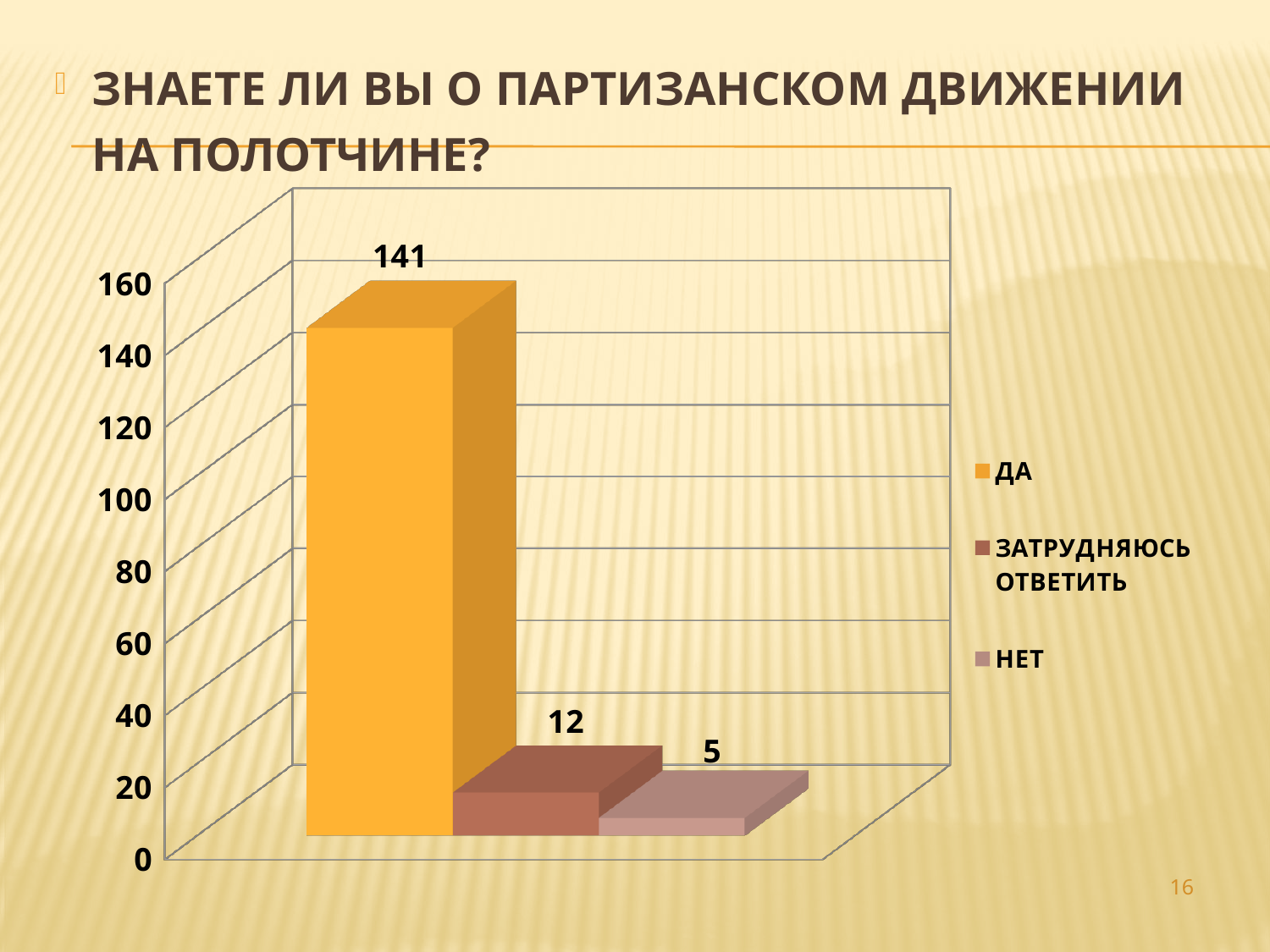
What is the value for НЕТ? 5 What is the value for ЗАТРУДНЯЮСЬ ОТВЕТИТЬ? 12 What kind of chart is shown on the slide? bar chart Is the value for ДА greater or less than 120? greater What is the difference between the values for ДА and ЗАТРУДНЯЮСЬ ОТВЕТИТЬ? 129 What is the value for ДА? 141 What colour is the bar for ДА? orange Which category has the lowest value? НЕТ How many entries does the legend list? 3 Which category has the highest value? ДА What is the difference between the values for ЗАТРУДНЯЮСЬ ОТВЕТИТЬ and НЕТ? 7 Which is larger, the value for ЗАТРУДНЯЮСЬ ОТВЕТИТЬ or the value for НЕТ? ЗАТРУДНЯЮСЬ ОТВЕТИТЬ